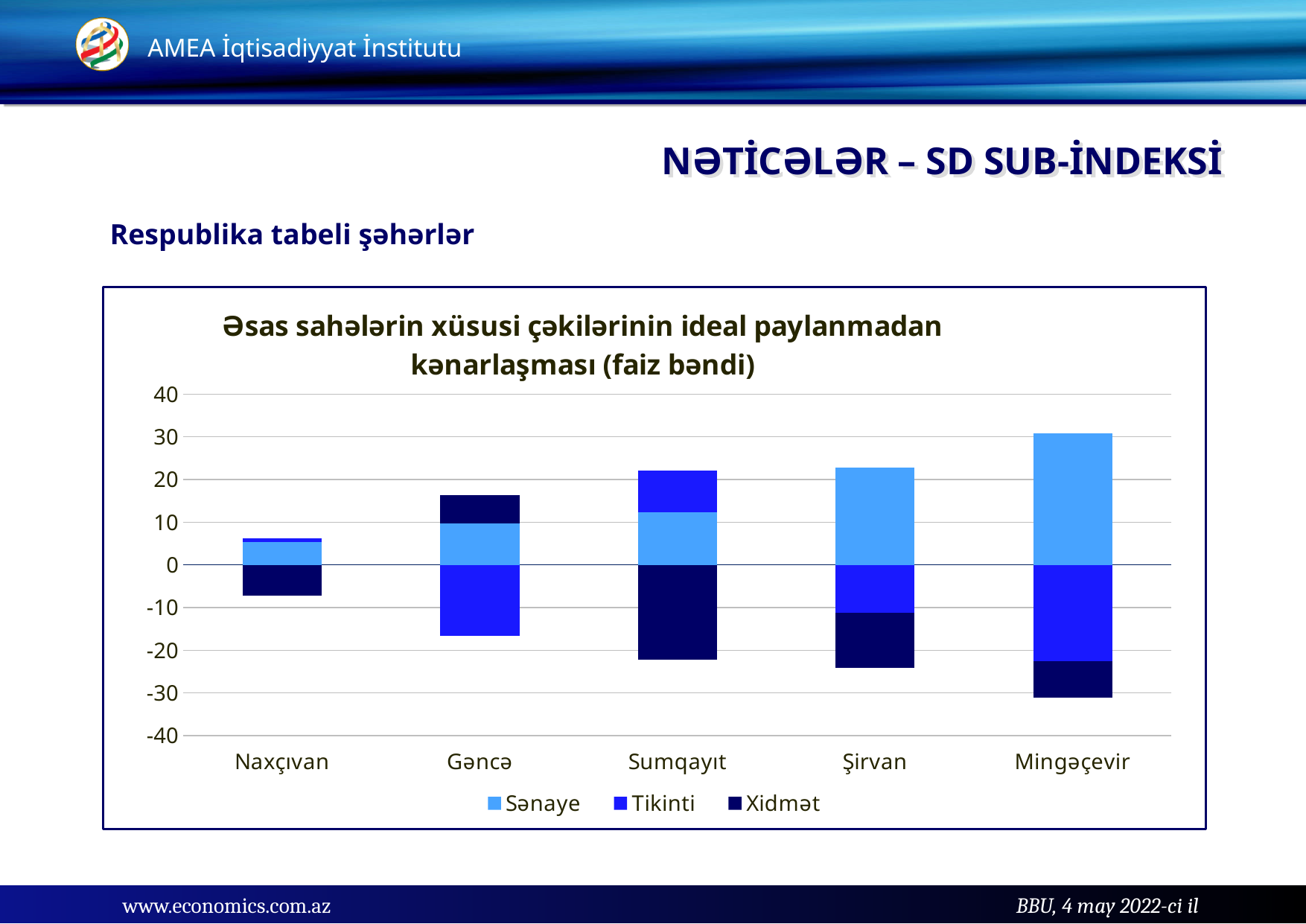
How many cities are shown on the x axis of the chart? 5 What kind of chart is shown on the slide? Stacked bar chart Which city has the largest Sənaye value? Mingəçevir What is the title of the chart? Əsas sahələrin xüsusi çəkilərinin ideal paylanmadan kənarlaşması (faiz bəndi) Is the Xidmət value for Sumqayıt greater or less than -20? less Which city has the larger Sənaye value, Şirvan or Sumqayıt? Şirvan What are the three series listed in the chart legend? Sənaye, Tikinti, Xidmət Is the Sənaye value for Naxçıvan greater or less than 10? less How many series does the chart legend list? 3 Is the Sənaye value for Mingəçevir greater or less than 20? greater Which city has the smallest Sənaye value? Naxçıvan